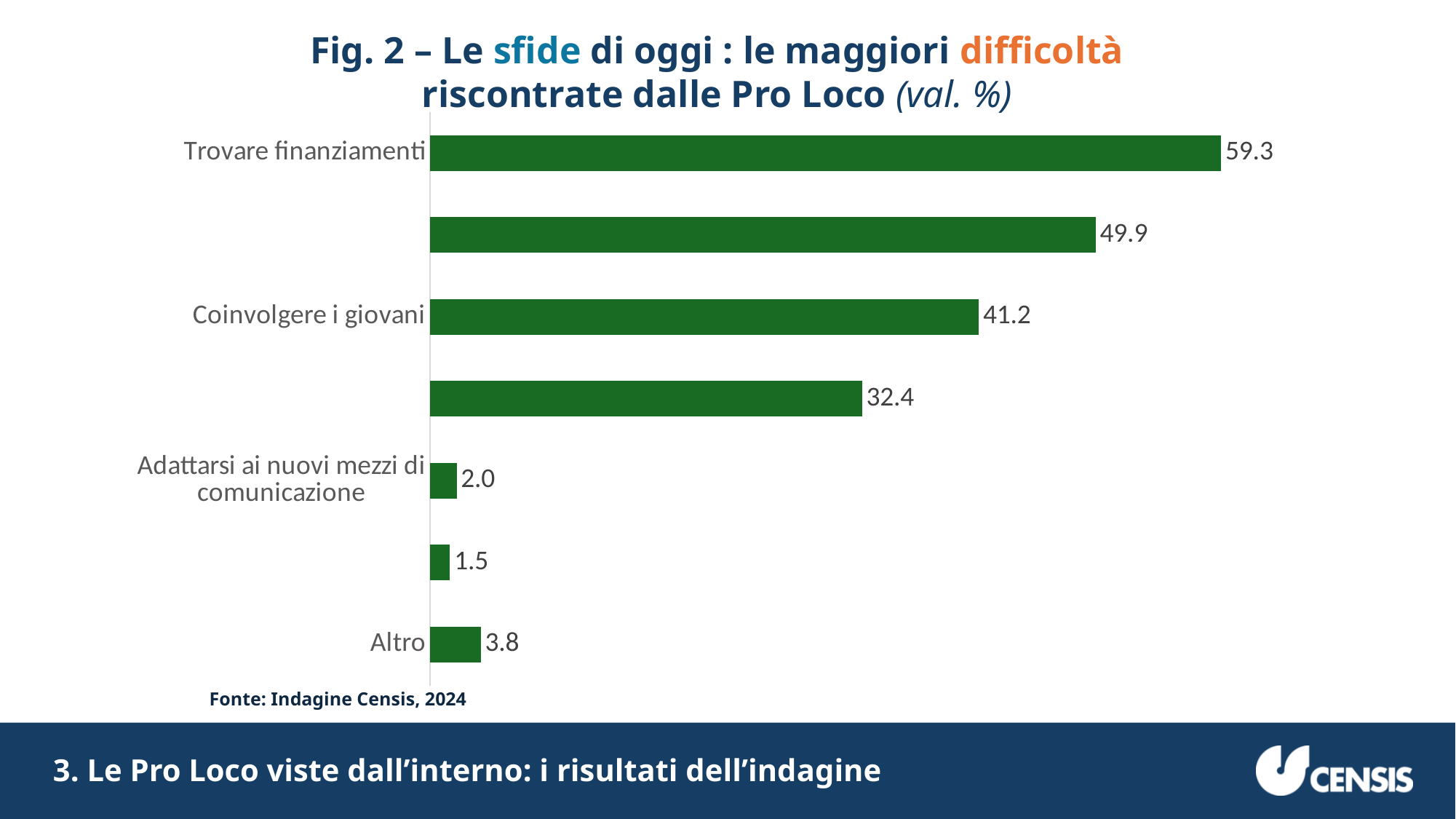
What type of chart is shown on the slide? bar chart How many bars are plotted on the chart? 7 What is the difference between the values for "Altro" and "Adattarsi ai nuovi mezzi di comunicazione"? 1.8 What is the value for "Altro"? 3.8 What source is cited below the chart? Fonte: Indagine Censis, 2024 What is the value for "Adattarsi ai nuovi mezzi di comunicazione"? 2.0 Which category has the highest value? Trovare finanziamenti What is the value for "Coinvolgere i giovani"? 41.2 What is the value for "Trovare finanziamenti"? 59.3 What is the smallest value shown on the chart? 1.5 What is the difference between the values for "Trovare finanziamenti" and "Coinvolgere i giovani"? 18.1 Which is larger, the value for "Altro" or the value for "Adattarsi ai nuovi mezzi di comunicazione"? Altro